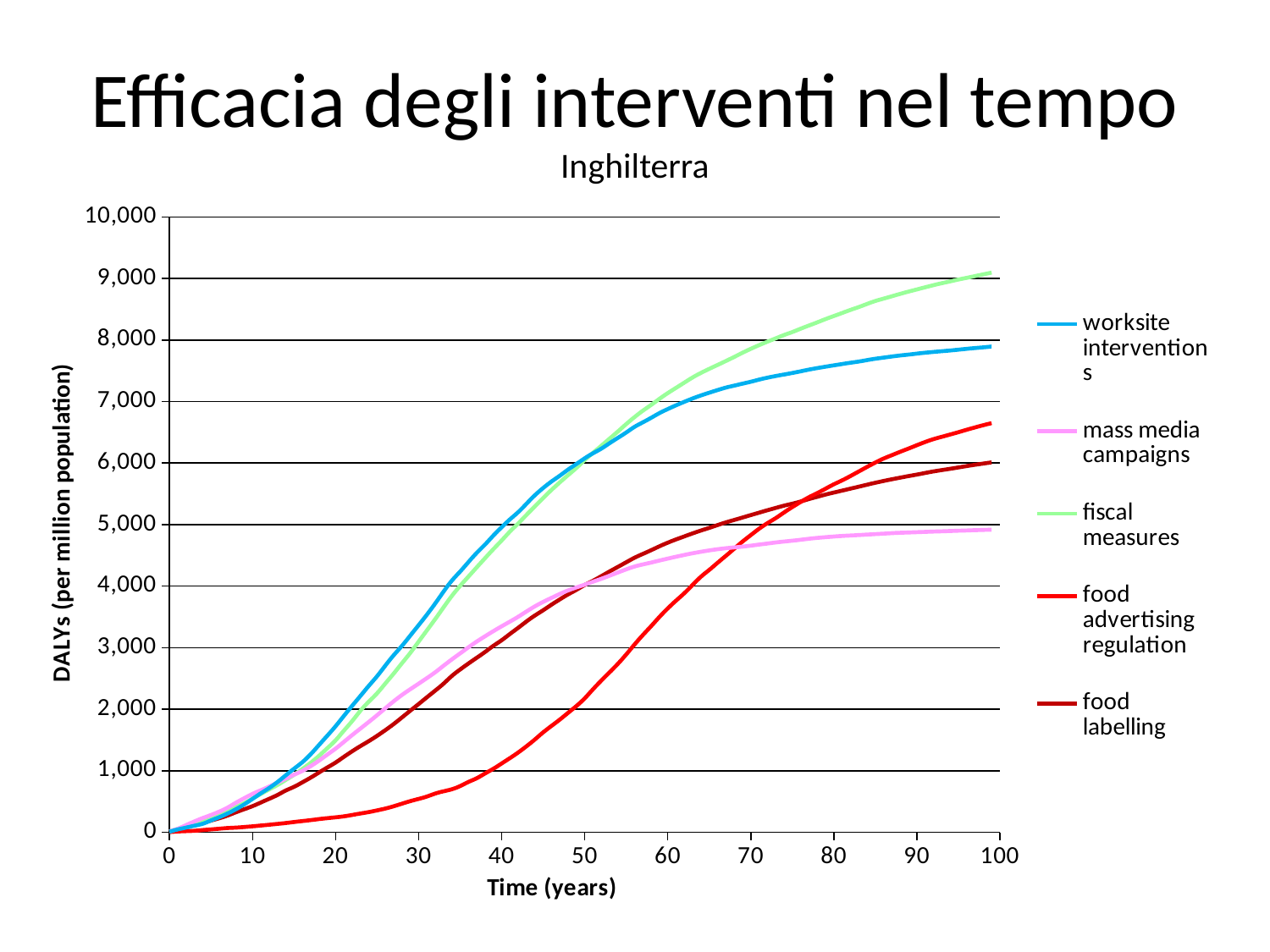
Which series has the lowest value at year 100? mass media campaigns Which series reaches the highest value at the end of the time axis (year 100)? fiscal measures Do the values for fiscal measures rise or fall as time increases? rise Is the value for worksite interventions at year 100 greater or less than 7,000? greater Is the value for fiscal measures at year 100 greater or less than 8,000? greater What is the label of the vertical axis? DALYs (per million population) At year 30, which is larger: worksite interventions or food advertising regulation? worksite interventions At year 100, which is larger: worksite interventions or food advertising regulation? worksite interventions What kind of chart is shown on the slide? line chart How many series does the legend list? 5 Is the value for mass media campaigns at year 100 greater or less than 6,000? less